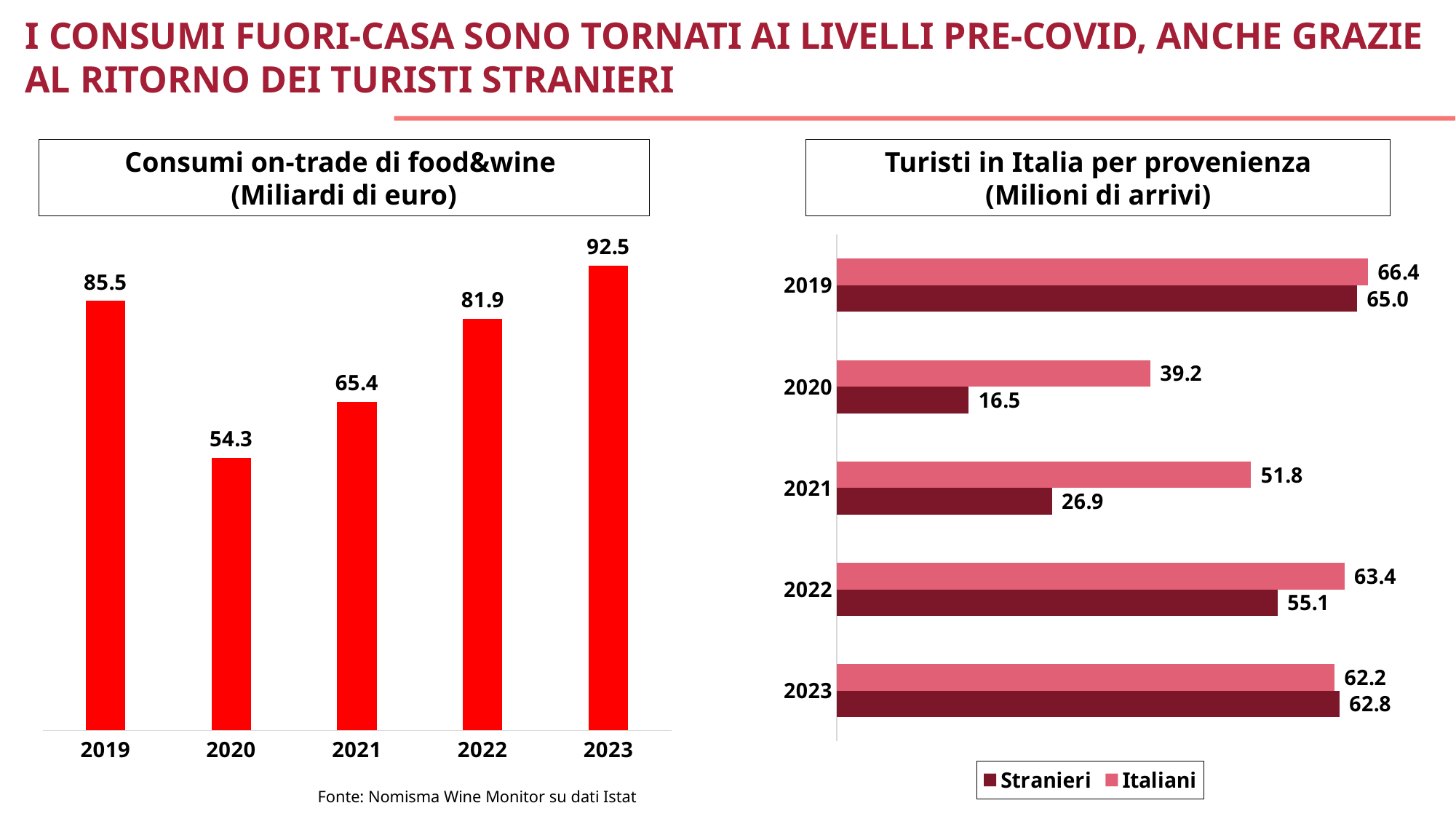
In the 'Turisti in Italia per provenienza' chart, how many series does the legend list? 2 In the 'Consumi on-trade di food&wine' chart, which year has the lowest value? 2020 In the 'Turisti in Italia per provenienza' chart, what is the difference between Italiani and Stranieri in 2021? 24.9 In the 'Consumi on-trade di food&wine' chart, which year has the highest value? 2023 In the 'Turisti in Italia per provenienza' chart, which year has the highest value for Italiani? 2019 In the 'Turisti in Italia per provenienza' chart, what is the value for Stranieri in 2020? 16.5 In the 'Consumi on-trade di food&wine' chart, how many years are shown? 5 In the 'Consumi on-trade di food&wine' chart, what is the value for 2021? 65.4 In the 'Turisti in Italia per provenienza' chart, what is the value for Italiani in 2022? 63.4 In the 'Consumi on-trade di food&wine' chart, what is the difference between the 2023 and 2019 values? 7.0 In the 'Turisti in Italia per provenienza' chart, which is larger in 2023, Stranieri or Italiani? Stranieri What kind of chart is the 'Consumi on-trade di food&wine' chart? Bar chart